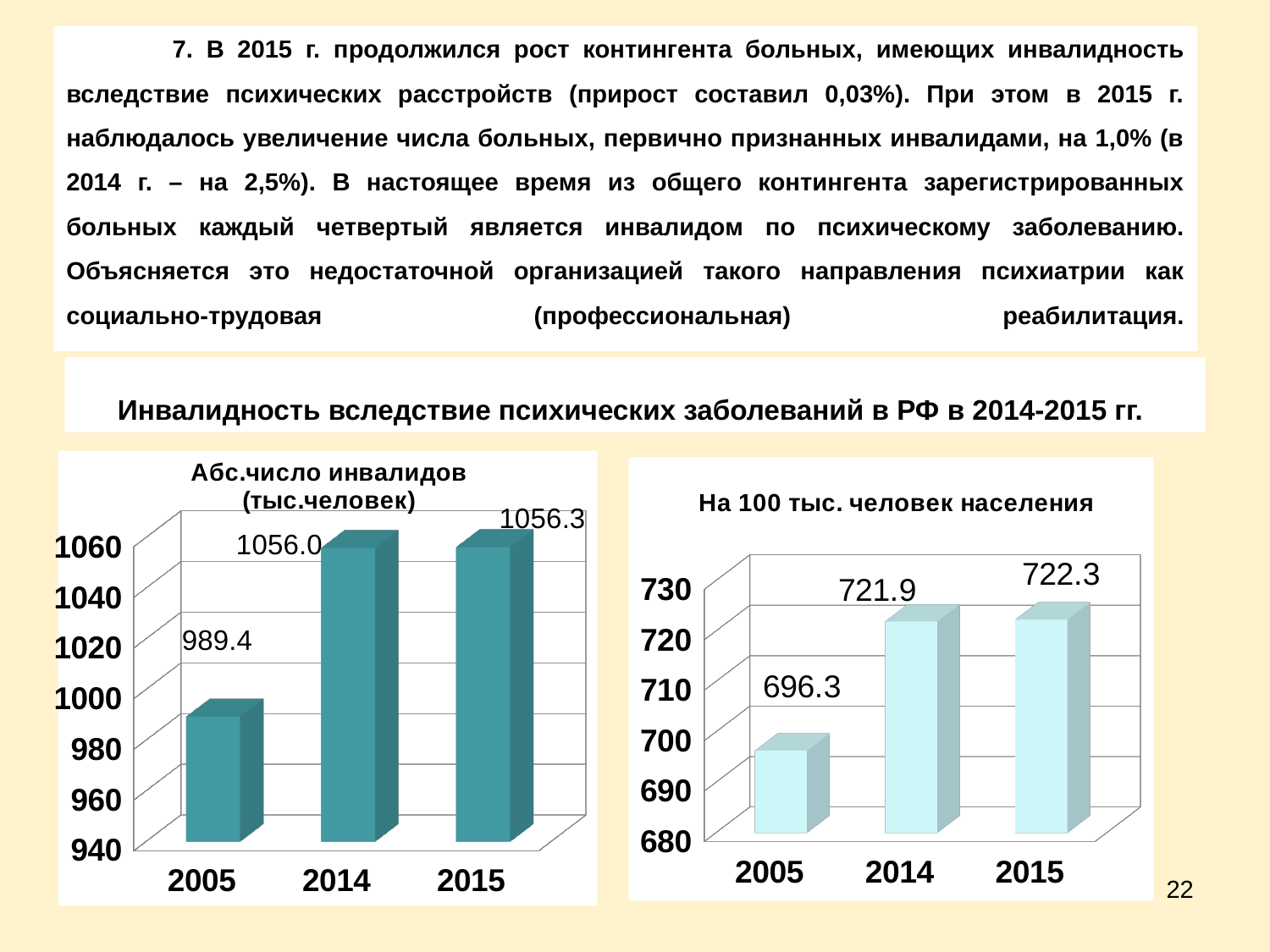
In the right chart 'На 100 тыс. человек населения', do the values rise or fall from 2005 to 2015? rise In the right chart 'На 100 тыс. человек населения', which is larger, the value for 2014 or the value for 2005? 2014 In the right chart 'На 100 тыс. человек населения', what is the value for 2015? 722.3 In the left chart 'Абс.число инвалидов (тыс.человек)', what is the value for 2014? 1056.0 In the left chart 'Абс.число инвалидов (тыс.человек)', which year has the lowest value? 2005 In the left chart 'Абс.число инвалидов (тыс.человек)', what is the difference between the values for 2014 and 2005? 66.6 In the right chart 'На 100 тыс. человек населения', which year has the lowest value? 2005 In the right chart 'На 100 тыс. человек населения', what is the difference between the values for 2015 and 2014? 0.4 In the right chart 'На 100 тыс. человек населения', what is the value for 2005? 696.3 How many years are shown on the x axis of the left chart 'Абс.число инвалидов (тыс.человек)'? 3 What kind of chart is the right chart 'На 100 тыс. человек населения'? bar chart In the left chart 'Абс.число инвалидов (тыс.человек)', what is the value for 2005? 989.4